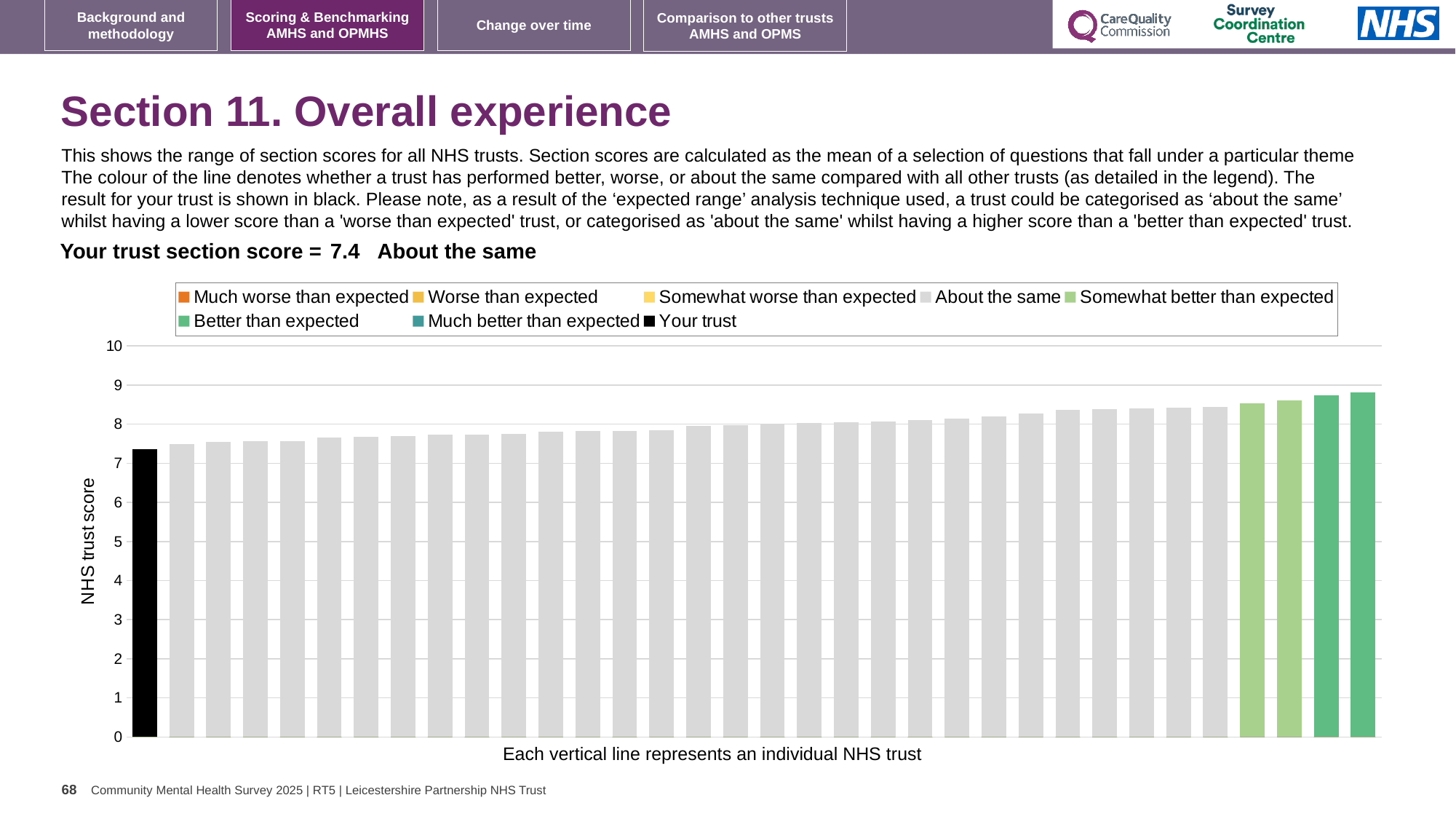
What colour is the bar for your trust? black How many entries does the legend list? 8 What is the label on the y axis? NHS trust score How many bars are coloured as 'Better than expected'? 2 Which bar has the lowest score? Your trust Is the value of the rightmost (highest) bar greater or less than 8? greater Is the value for your trust greater or less than 7? greater What kind of chart is shown on the slide? bar chart Which category is your trust placed in compared with other trusts? About the same Do the bar values rise or fall from left to right along the x axis? rise Is the value for your trust greater or less than 8? less What is the section score for your trust? 7.4